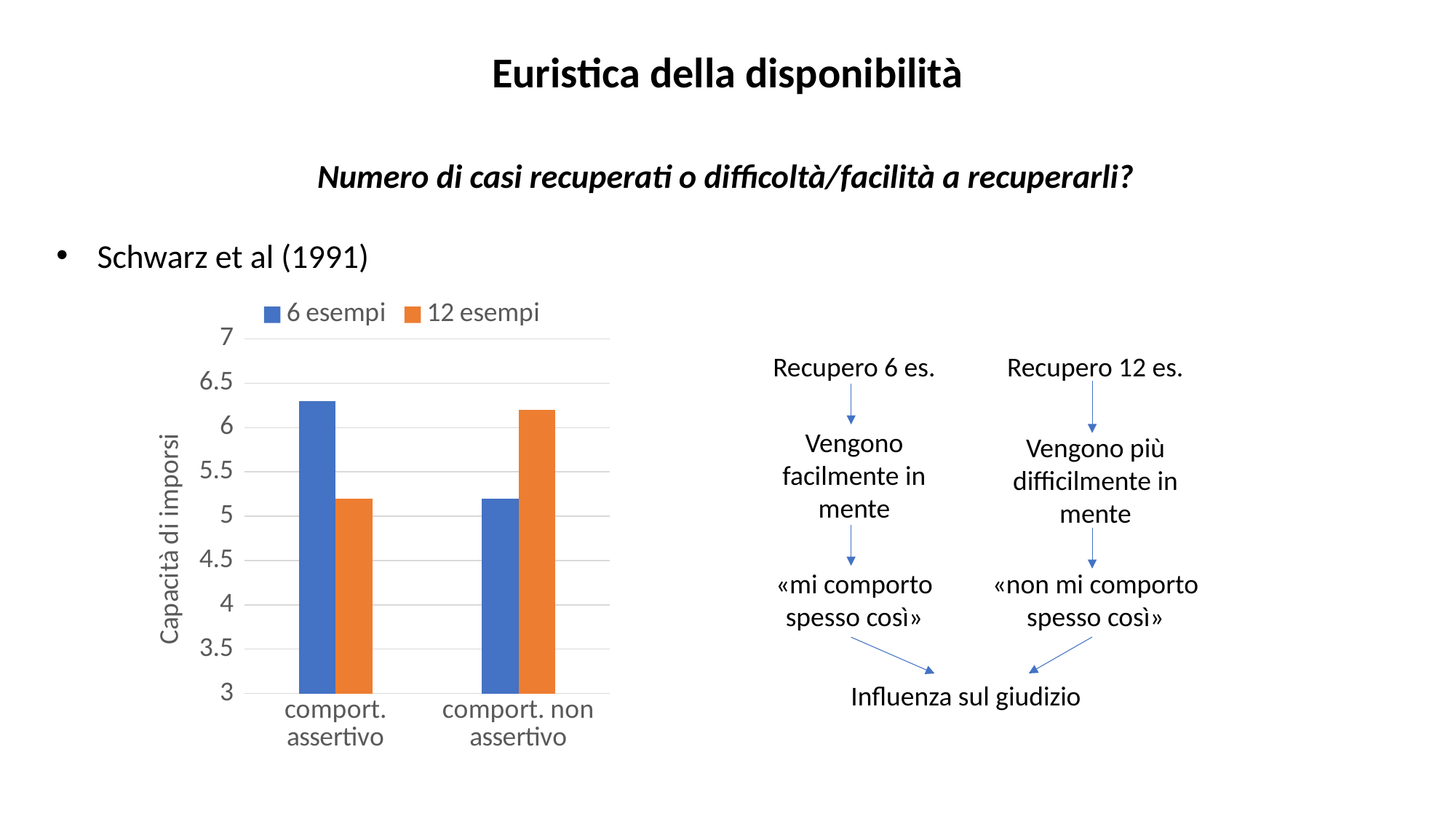
What kind of chart is shown on the slide? bar chart How many categories are shown on the x axis of the chart? 2 What are the two series named in the chart legend? 6 esempi and 12 esempi How many series does the chart legend list? 2 Is the value for 6 esempi in the comport. assertivo category greater or less than 6? greater Is the value for 6 esempi in the comport. non assertivo category greater or less than 5.5? less In the comport. non assertivo category, which series has the larger value, 6 esempi or 12 esempi? 12 esempi What is the title of the vertical axis of the chart? Capacità di imporsi In the comport. assertivo category, which series has the larger value, 6 esempi or 12 esempi? 6 esempi For the 6 esempi series, which category has the higher value? comport. assertivo Is the value for 12 esempi in the comport. non assertivo category greater or less than 6? greater